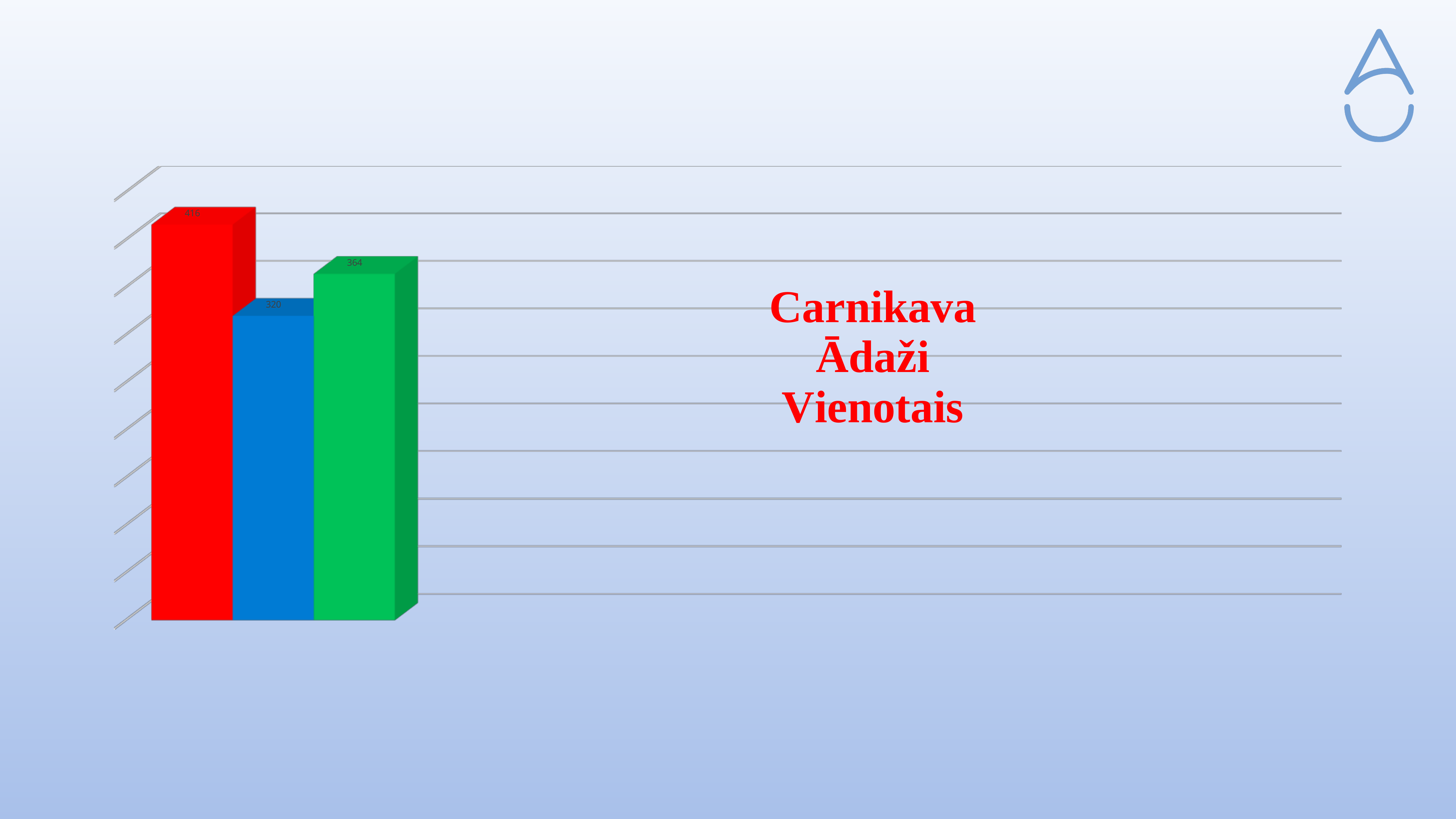
Which bar has the lowest value? The blue bar What is the difference between the red bar's value and the green bar's value? 52 What colour is the leftmost bar in the chart? Red What value is shown on the red bar? 416 What value is shown on the green bar? 364 What kind of chart is shown on the slide? Bar chart What is the difference between the green bar's value and the blue bar's value? 44 How many bars are plotted in the chart? 3 Which is larger, the value of the green bar or the value of the blue bar? The green bar Which bar has the highest value? The red bar What value is shown on the blue bar? 320 What is the difference between the red bar's value and the blue bar's value? 96